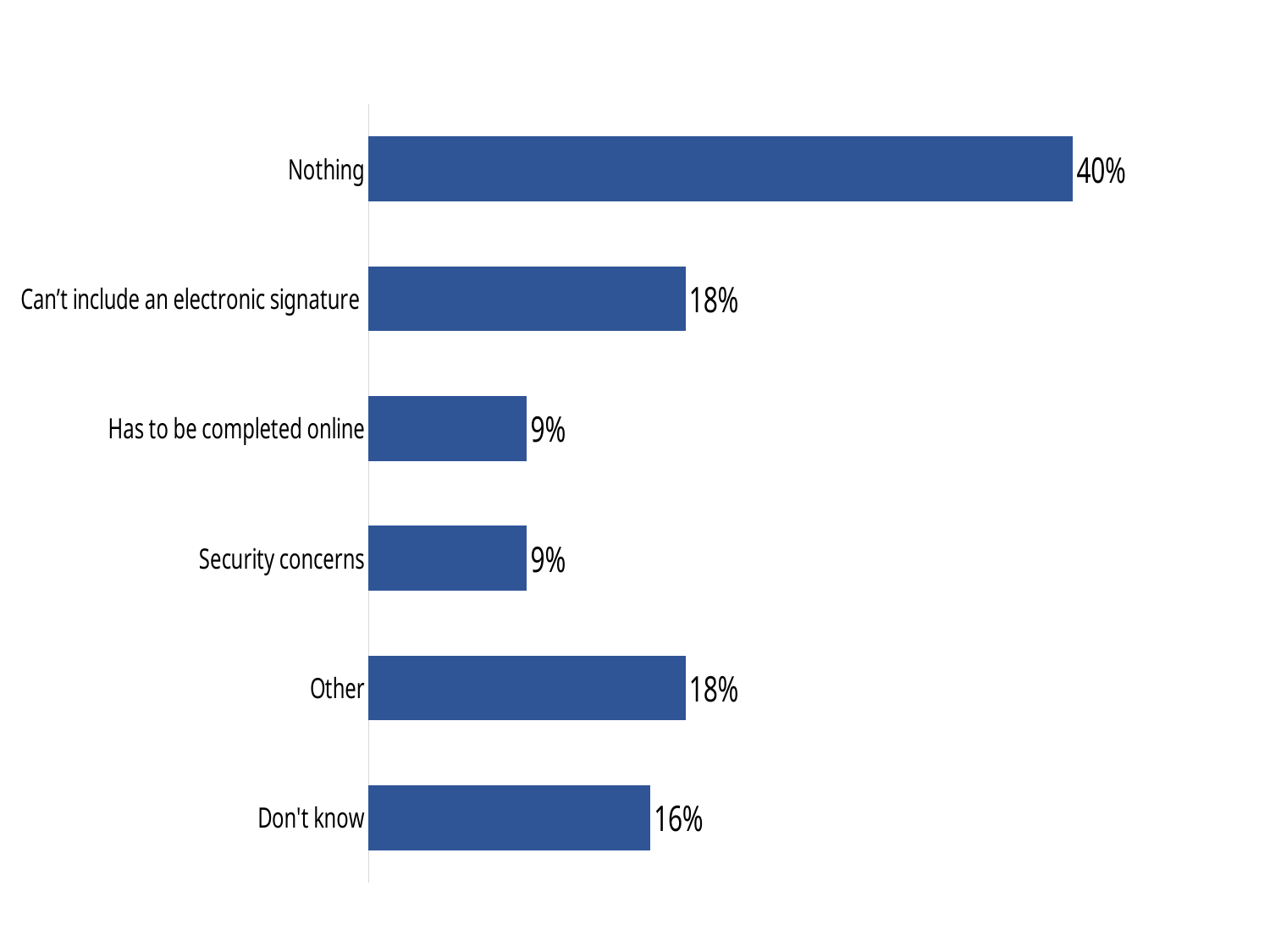
What kind of chart is shown on the slide? Bar chart Which two categories both have a value of 9%? Has to be completed online and Security concerns What is the value for Nothing? 40% Which is larger, the value for Nothing or the value for Other? Nothing What is the value for Security concerns? 9% Which category has the highest value? Nothing What is the value for Don't know? 16% What is the value for Can't include an electronic signature? 18% What is the difference between the values for Other and Has to be completed online? 9% How many categories are shown in the chart? 6 Which is larger, the value for Don't know or the value for Security concerns? Don't know What is the difference between the values for Nothing and Don't know? 24%